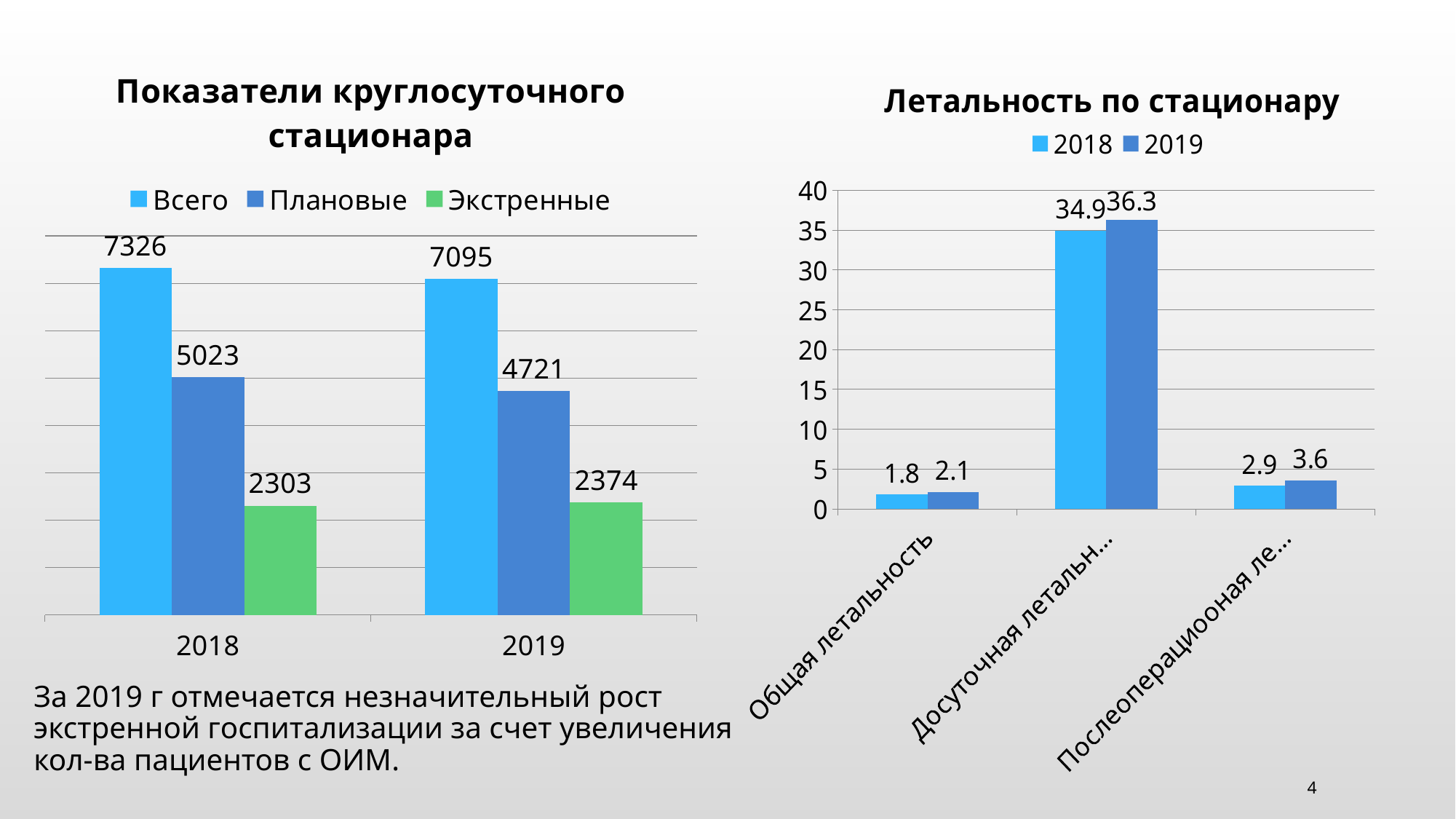
In the chart titled 'Летальность по стационару', what is the 2019 value for 'Общая летальность'? 2.1 In the chart titled 'Летальность по стационару', how many categories are shown on the x axis? 3 In the chart titled 'Летальность по стационару', what is the difference between the 2019 and 2018 values for the rightmost category? 0.7 In the chart titled 'Показатели круглосуточного стационара', how many series does the legend list? 3 In the chart titled 'Показатели круглосуточного стационара', what is the value of 'Плановые' for 2019? 4721 In the chart titled 'Летальность по стационару', which category has the highest values? The middle category (Досуточная летальн...) In the chart titled 'Показатели круглосуточного стационара', what is the difference between 'Всего' in 2018 and 'Всего' in 2019? 231 In the chart titled 'Показатели круглосуточного стационара', which year has the larger value for 'Экстренные'? 2019 What type of chart is the chart titled 'Летальность по стационару'? Bar chart In the chart titled 'Показатели круглосуточного стационара', which series is shown in green? Экстренные In the chart titled 'Летальность по стационару', what is the 2018 value for the middle category? 34.9 In the chart titled 'Показатели круглосуточного стационара', what is the value of 'Всего' for 2018? 7326